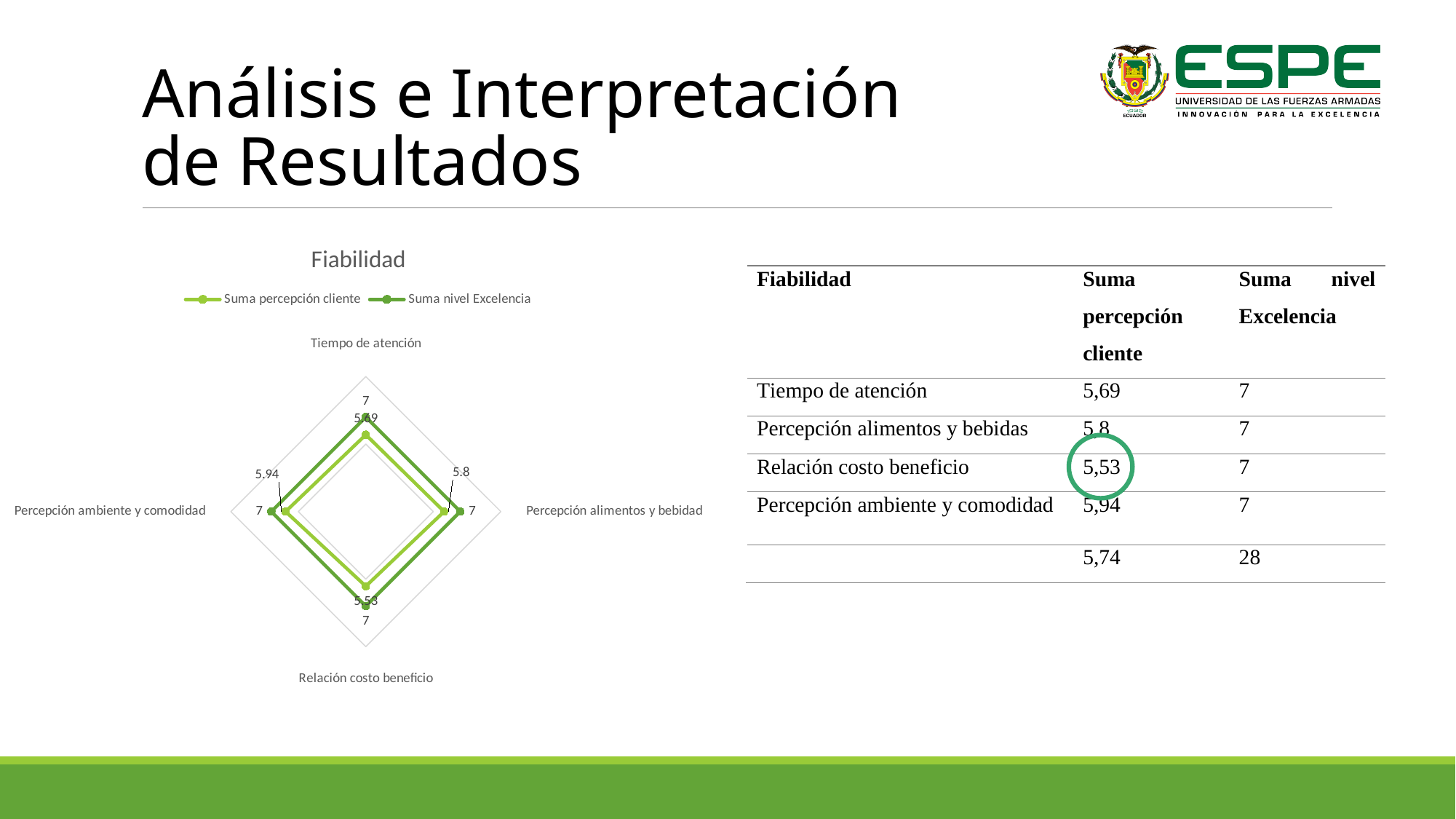
What are the two series names shown in the chart legend? Suma percepción cliente and Suma nivel Excelencia For Suma percepción cliente, which is larger: Percepción alimentos y bebidad or Tiempo de atención? Percepción alimentos y bebidad Which category has the lowest Suma percepción cliente value? Relación costo beneficio For Relación costo beneficio, what is the difference between the Suma nivel Excelencia value and the Suma percepción cliente value? 1,47 What is the Suma percepción cliente value for Relación costo beneficio? 5,53 What is the Suma nivel Excelencia value for Tiempo de atención? 7 How many series does the chart legend list? 2 What kind of chart is shown on the slide? Radar chart How many categories (axes) does the radar chart have? 4 What is the title of the chart? Fiabilidad Which category has the highest Suma percepción cliente value? Percepción ambiente y comodidad What is the Suma percepción cliente value for Percepción ambiente y comodidad? 5,94